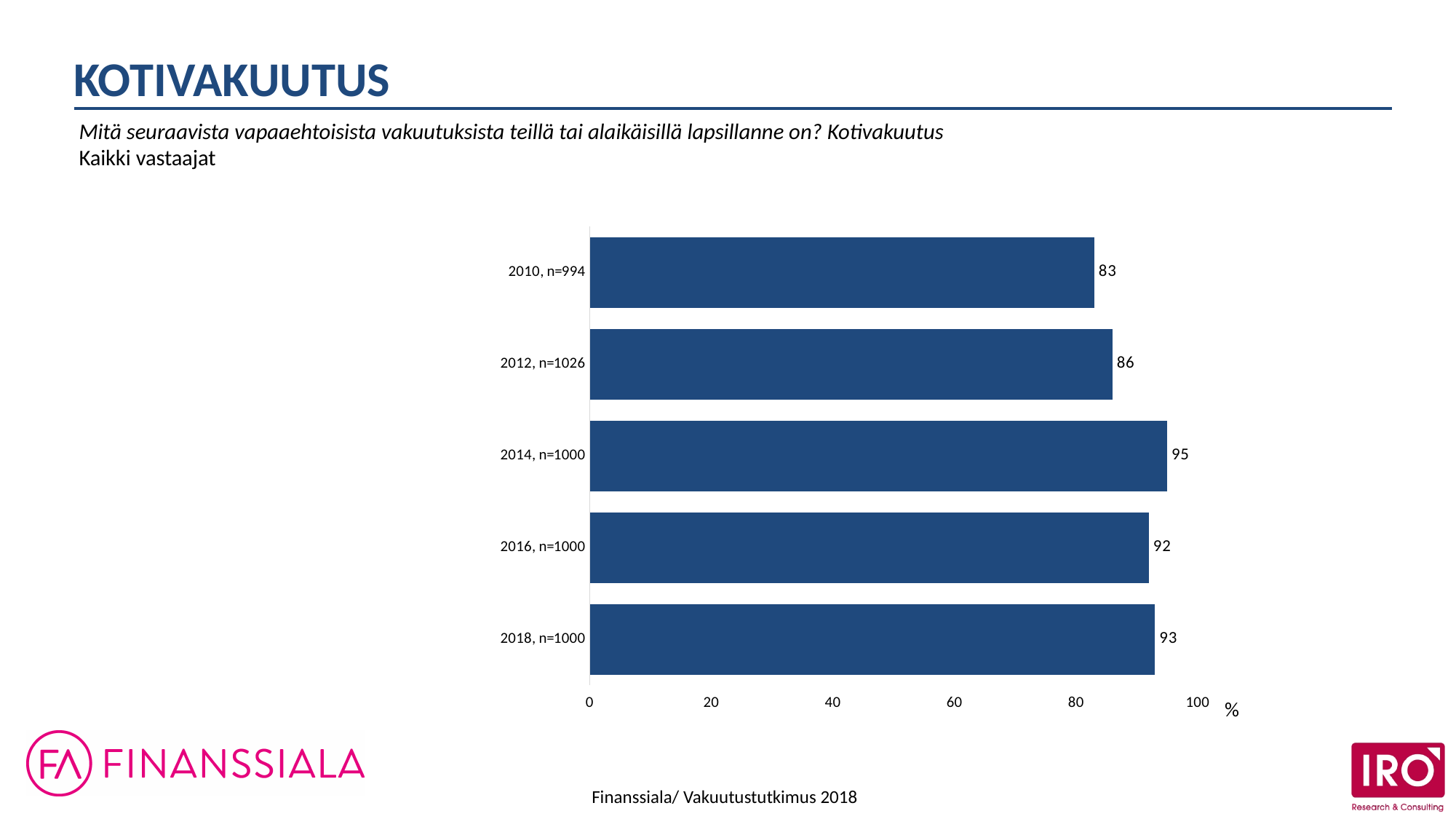
What kind of chart is shown on the slide? bar chart Is the value for 2012, n=1026 greater or less than 80? greater What unit is shown at the end of the horizontal axis? % What is the value for 2018, n=1000? 93 What is the value for 2010, n=994? 83 Which category has the highest value? 2014, n=1000 What is the difference between the values for 2018, n=1000 and 2016, n=1000? 1 What is the difference between the values for 2014, n=1000 and 2010, n=994? 12 Which is larger, the value for 2016, n=1000 or the value for 2012, n=1026? 2016, n=1000 What is the value for 2014, n=1000? 95 Which category has the lowest value? 2010, n=994 How many categories are shown in the chart? 5